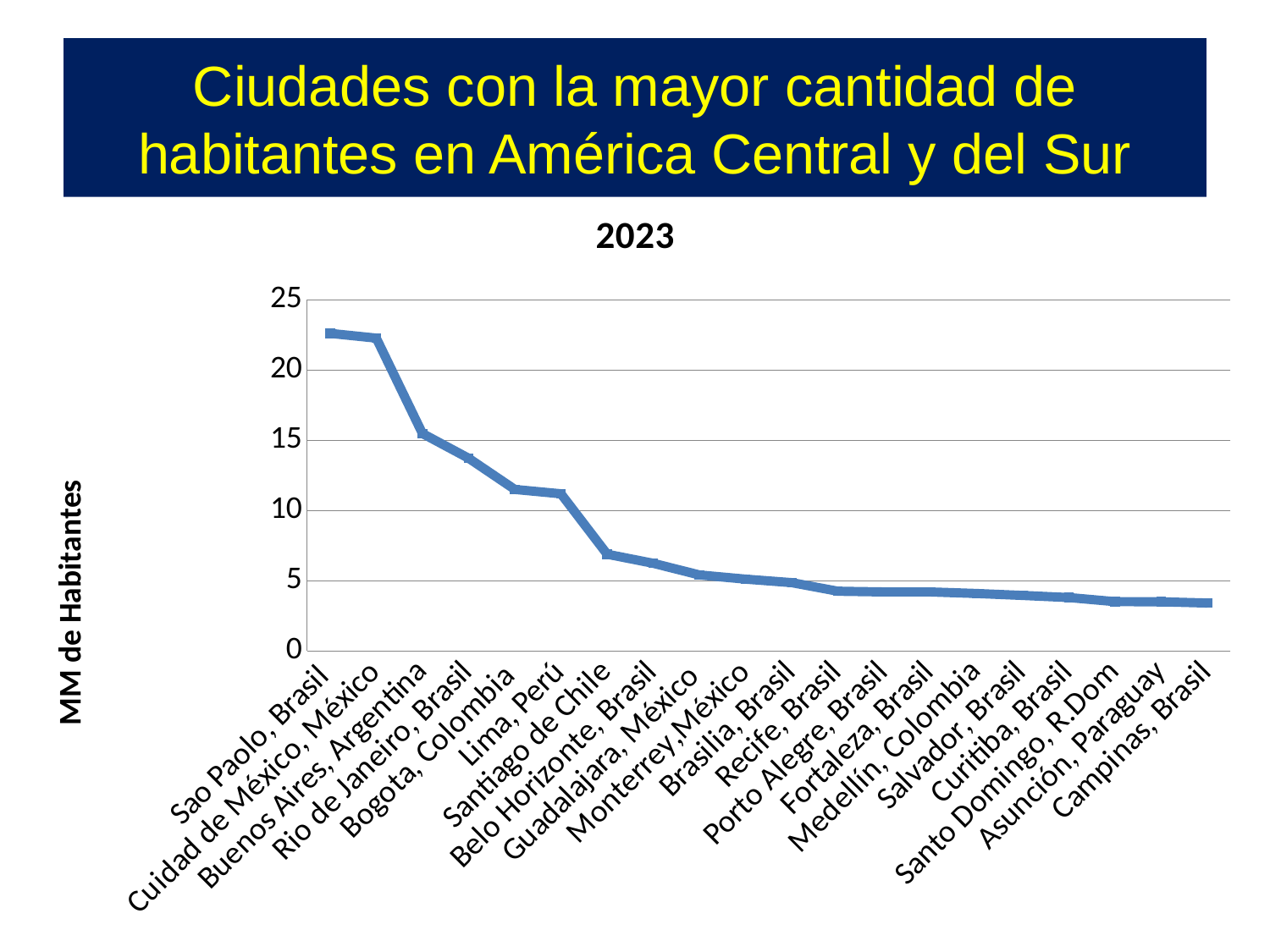
What kind of chart is shown on the slide? line chart Is the value for Santiago de Chile greater or less than 10? less What is the title of the chart? 2023 How many cities are plotted along the x axis of the chart? 20 Do the values rise or fall moving from left to right along the x axis? fall What is the label on the vertical axis of the chart? MM de Habitantes Which has a larger value, Lima, Perú or Santiago de Chile? Lima, Perú Is the value for Bogota, Colombia greater or less than 10? greater Is the value for Sao Paolo, Brasil greater or less than 20? greater Which has a larger value, Buenos Aires, Argentina or Rio de Janeiro, Brasil? Buenos Aires, Argentina